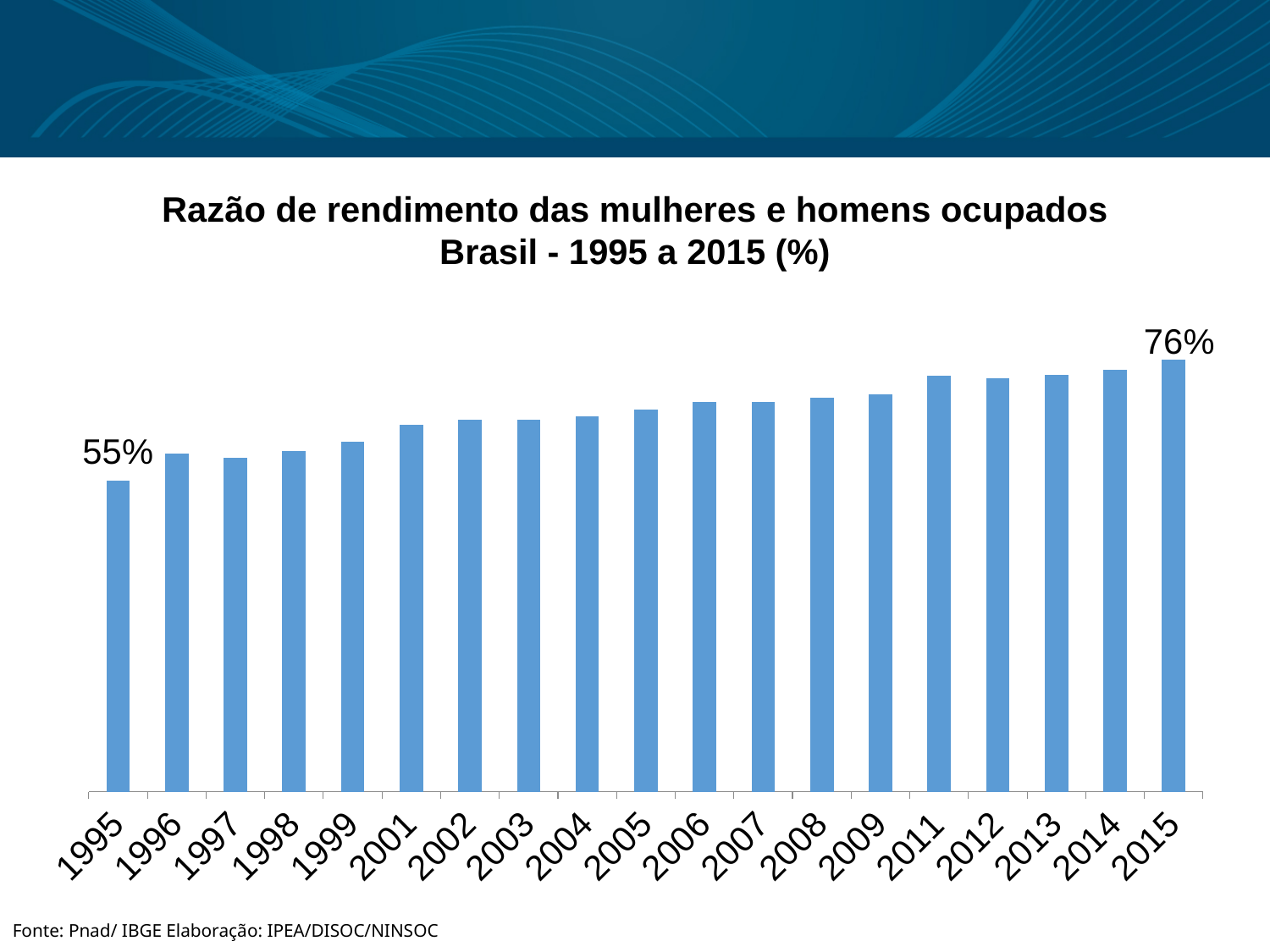
What is the difference between the values for 2015 and 1995? 21 percentage points Which year has the highest value? 2015 What is the source cited below the chart? Pnad/ IBGE Elaboração: IPEA/DISOC/NINSOC Do the values generally rise or fall from 1995 to 2015? Rise What kind of chart is shown on the slide? Bar chart What is the value for 1995? 55% What is the value for 2015? 76% What is the title of the chart? Razão de rendimento das mulheres e homens ocupados Brasil - 1995 a 2015 (%) Which is larger, the value for 2011 or the value for 1999? 2011 Which is larger, the value for 1997 or the value for 2005? 2005 Which year has the lowest value? 1995 How many years are shown on the x axis? 19